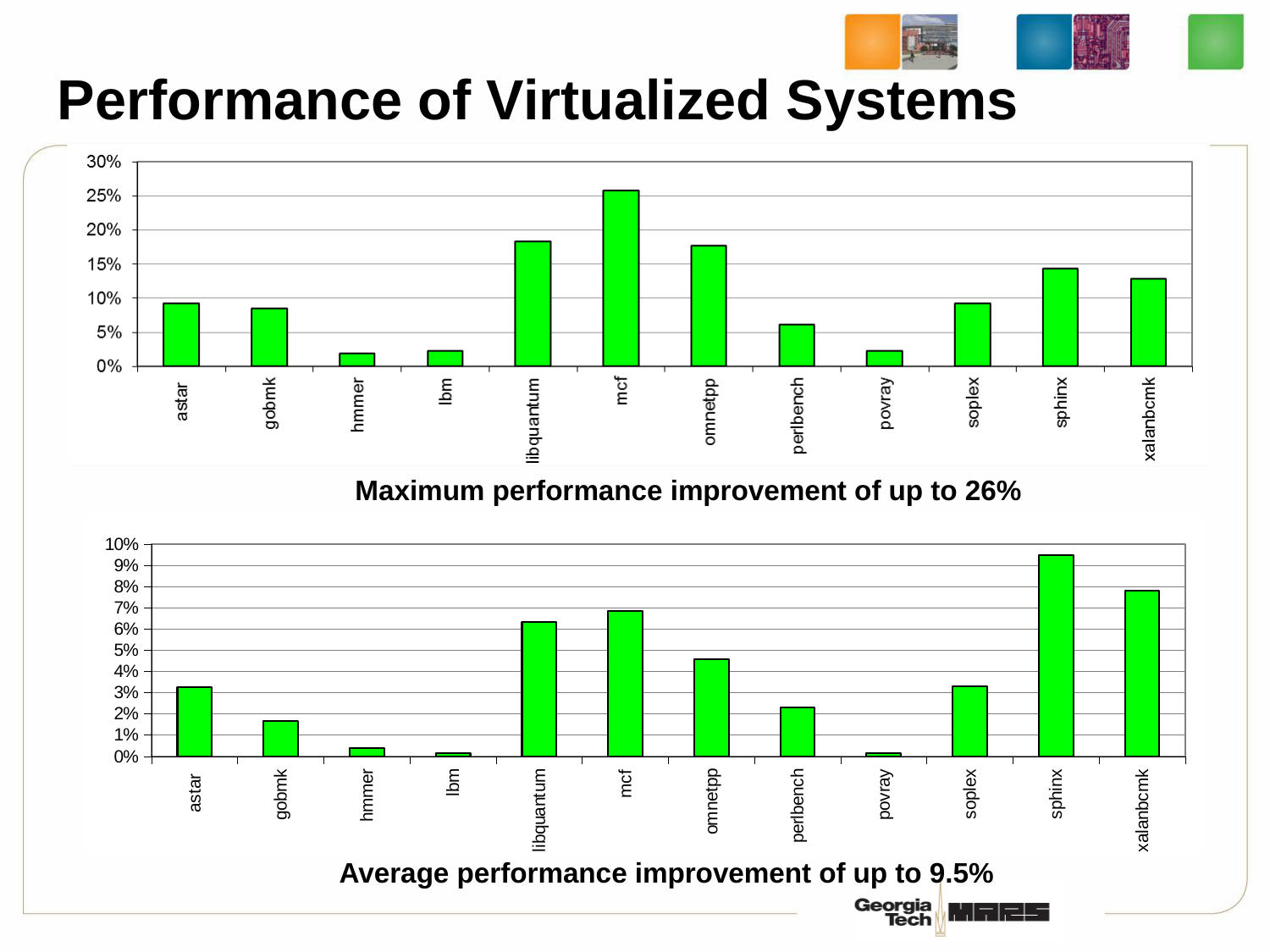
In the top chart, is the value for mcf greater or less than 25%? greater In the bottom chart, which is larger, the value for astar or the value for gobmk? astar In the top chart, is the value for astar greater or less than 10%? less What kind of chart is the bottom chart? bar chart In the top chart, which category has the highest value? mcf In the bottom chart, which category has the highest value? sphinx In the top chart, is the value for libquantum greater or less than 15%? greater How many categories are shown on the x axis of the top chart? 12 In the top chart, which is larger, the value for sphinx or the value for xalanbcmk? sphinx